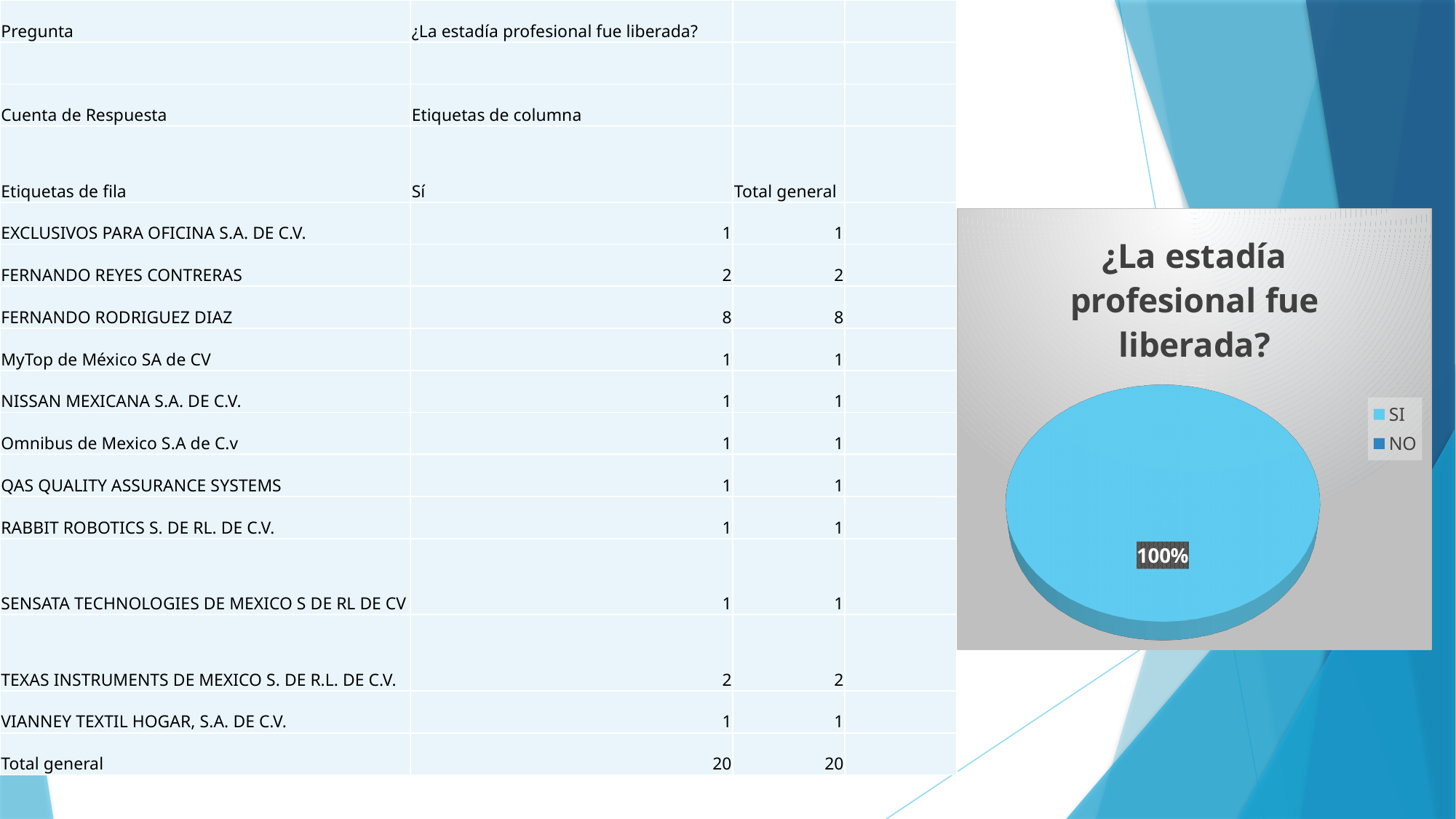
Which legend entry has no visible slice in the pie chart? NO What share of the pie chart does the SI slice represent? 100% Which category has the largest share of the pie chart? SI How many slices are visible in the pie chart? 1 What kind of chart is shown on the slide? pie chart What is the title of the pie chart? ¿La estadía profesional fue liberada? Which of the two categories, SI or NO, has the larger share of the pie chart? SI What percentage value is printed on the pie chart? 100% How many entries does the legend of the pie chart list? 2 What colour is used for the SI category in the pie chart? light blue